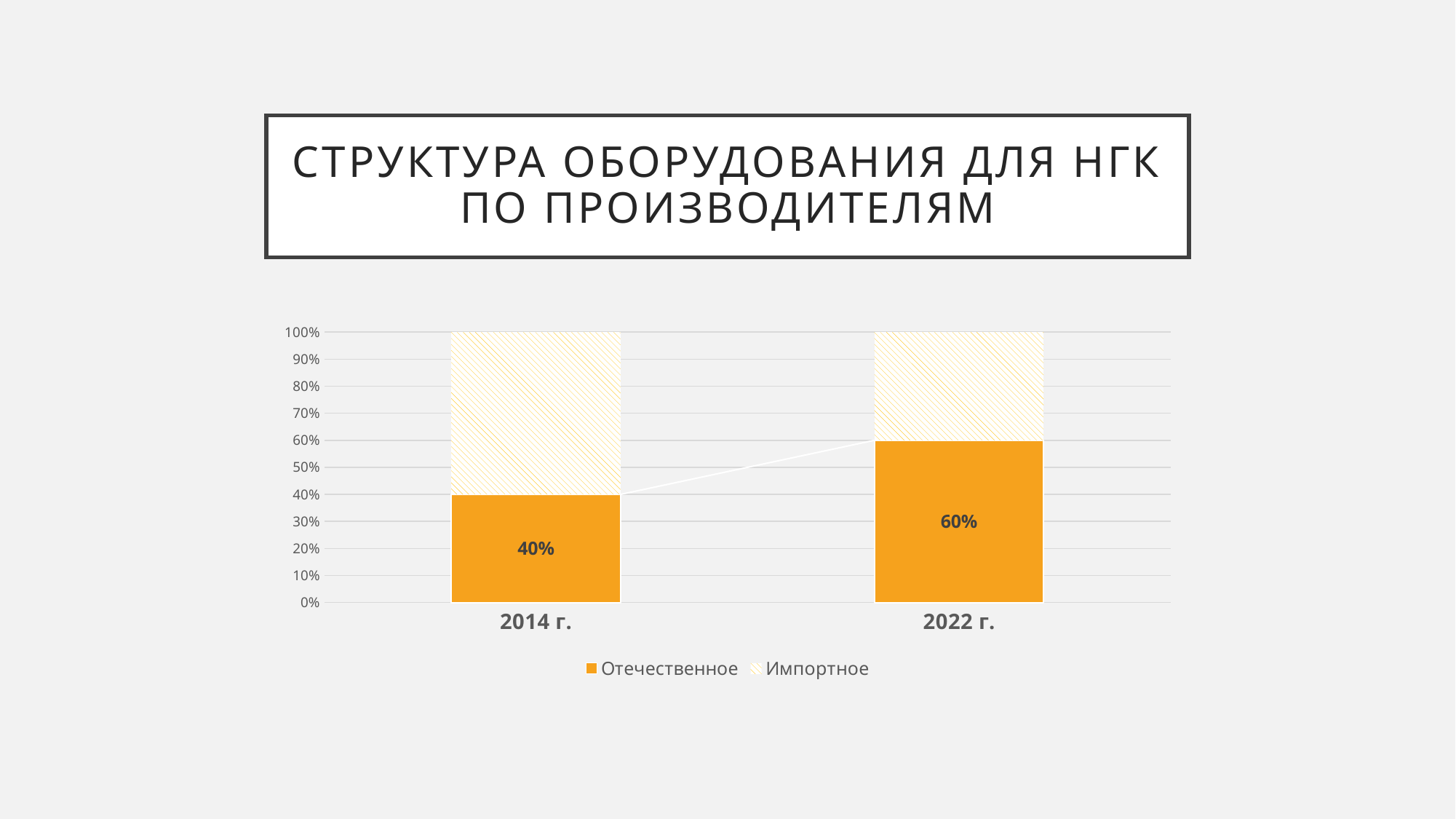
Does the Отечественное share rise or fall from 2014 г. to 2022 г.? Rise Is the Импортное share for 2014 г. greater or less than 50%? greater What is the value for Отечественное in 2014 г.? 40% Which series is shown with a solid orange fill in the legend? Отечественное How many categories are shown on the x axis? 2 What is the value for Отечественное in 2022 г.? 60% How many series does the legend list? 2 What kind of chart is shown on the slide? Stacked bar chart Which category has the lowest value for Отечественное? 2014 г. Which year has the higher value for Отечественное, 2014 г. or 2022 г.? 2022 г. Is the Импортное share for 2022 г. greater or less than 50%? less What is the difference between the Отечественное values for 2022 г. and 2014 г.? 20%